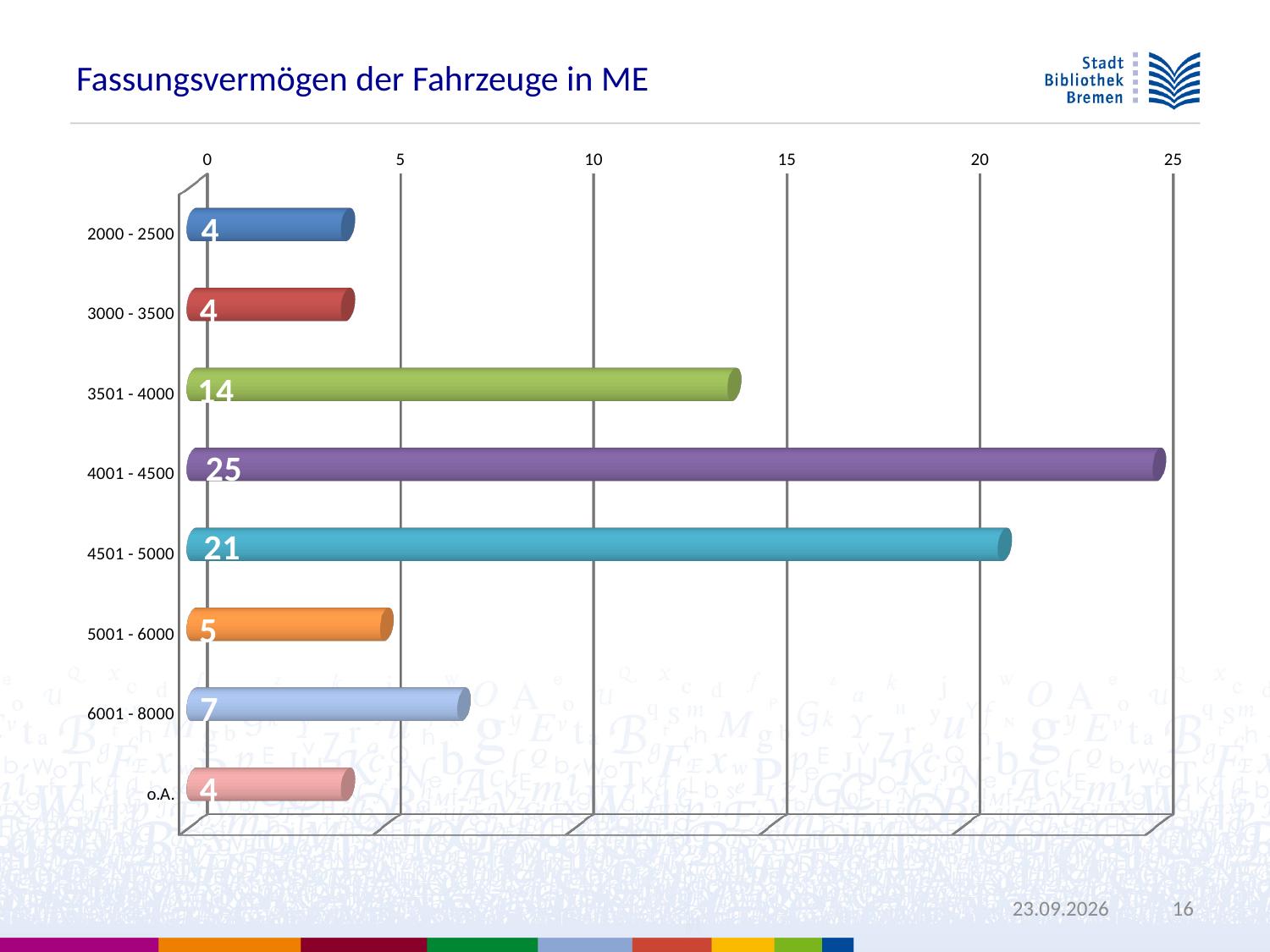
What is the value for the category 6001 - 8000? 7 How many categories are shown in the chart? 8 What is the difference between the values for 3501 - 4000 and 5001 - 6000? 9 What is the title of the chart? Fassungsvermögen der Fahrzeuge in ME What is the difference between the values for 4001 - 4500 and 4501 - 5000? 4 Which is larger, the value for 5001 - 6000 or the value for 6001 - 8000? 6001 - 8000 Is the value for 4501 - 5000 greater or less than 20? greater What kind of chart is shown on the slide? bar chart Which category has the highest value? 4001 - 4500 What is the value for the category 3501 - 4000? 14 What is the value for the category 4501 - 5000? 21 What is the value for the category o.A.? 4